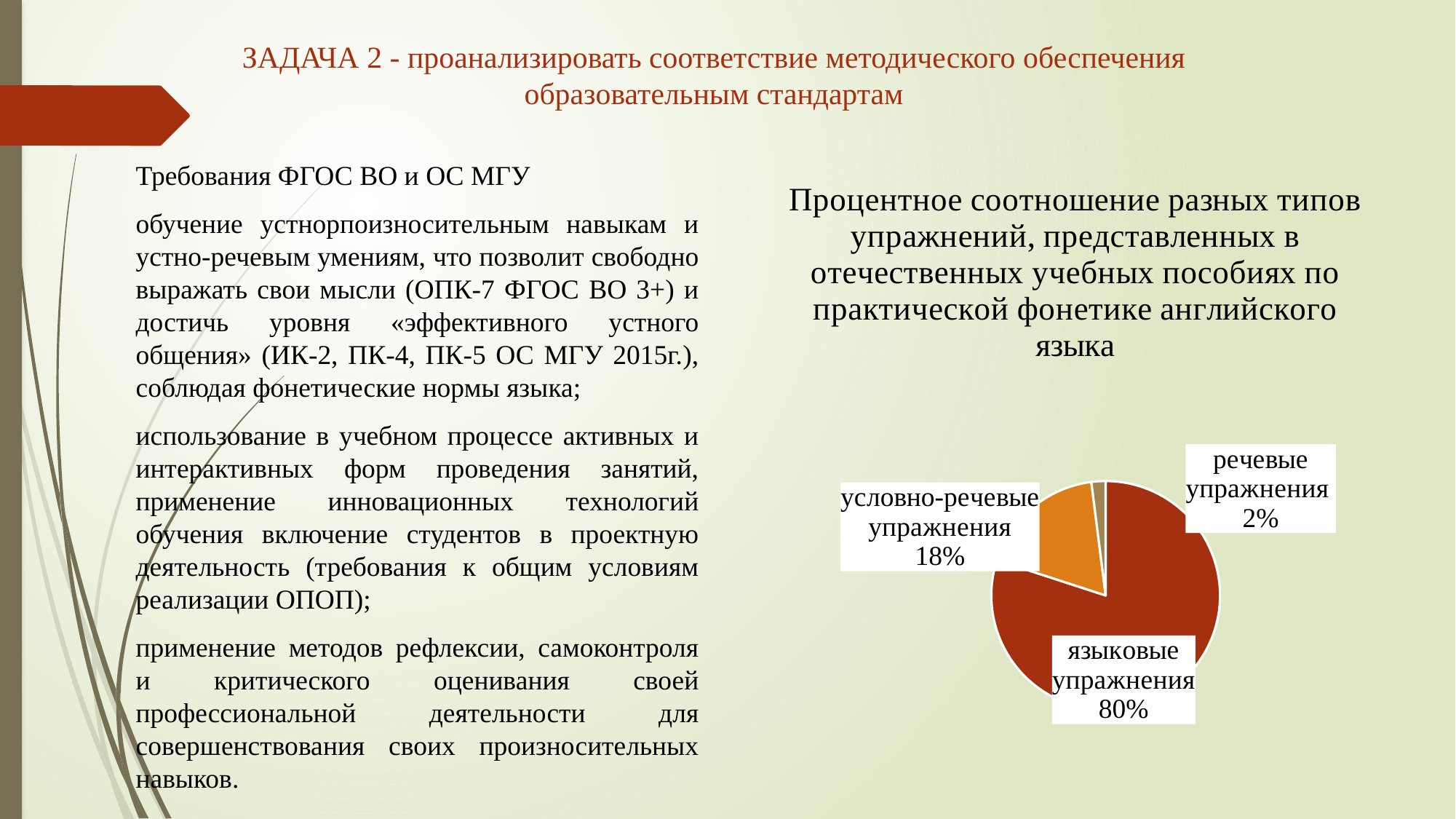
How many slices does the pie chart have? 3 What share of the pie is labelled "условно-речевые упражнения"? 18% What share of the pie is labelled "речевые упражнения"? 2% What colour is the slice for "условно-речевые упражнения"? orange What kind of chart is shown on the slide? pie chart What is the title of the pie chart? Процентное соотношение разных типов упражнений, представленных в отечественных учебных пособиях по практической фонетике английского языка What is the difference in percentage points between "языковые упражнения" and "условно-речевые упражнения"? 62 What is the difference in percentage points between "условно-речевые упражнения" and "речевые упражнения"? 16 Which is larger: the share for "условно-речевые упражнения" or the share for "речевые упражнения"? условно-речевые упражнения What share of the pie is labelled "языковые упражнения"? 80% Which type of exercise has the largest share of the pie? языковые упражнения Which type of exercise has the smallest share of the pie? речевые упражнения